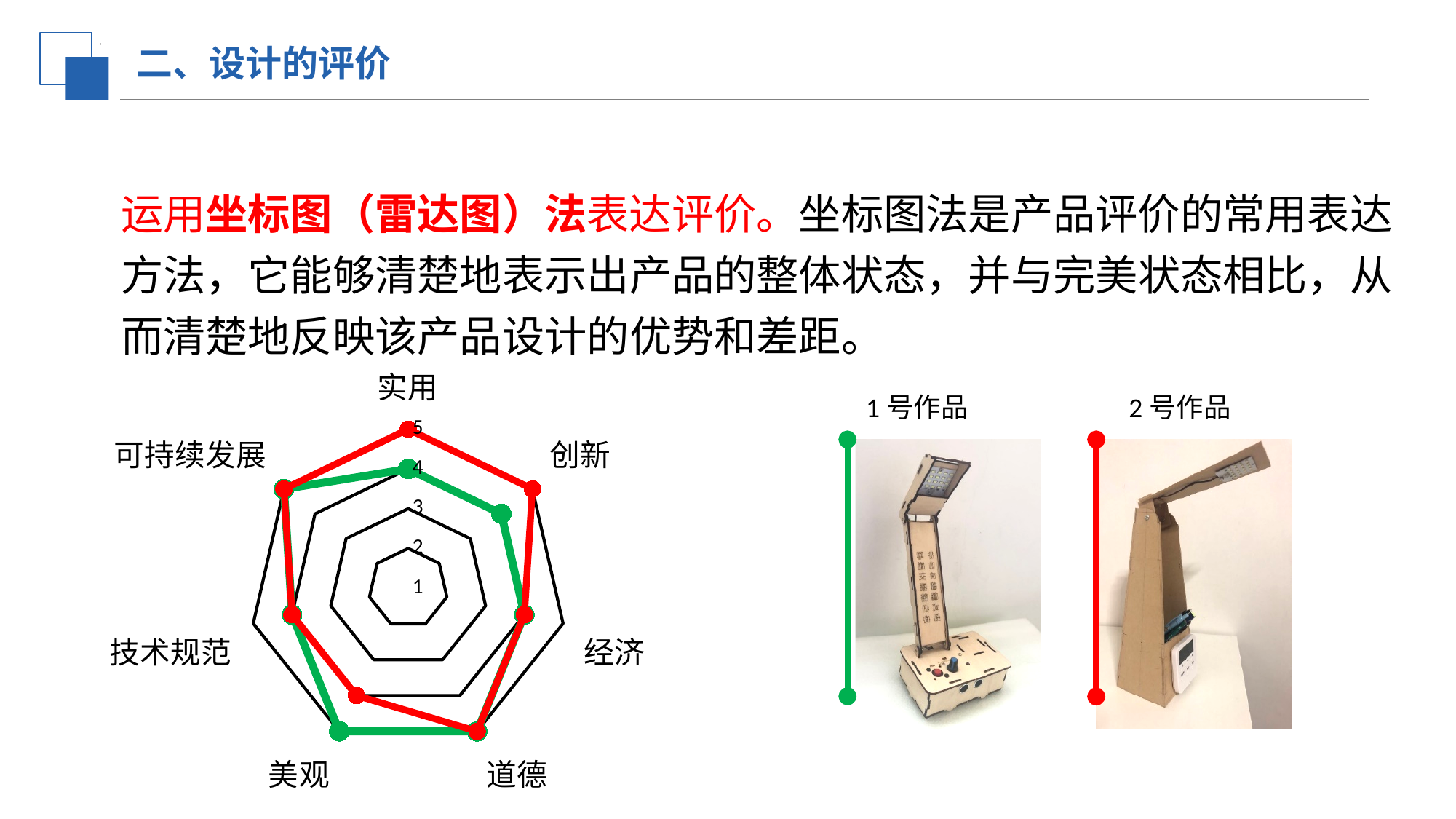
Which product scores higher on 实用, 1号作品 or 2号作品? 2号作品 What is the score of 1号作品 (green line) for 美观? 5 What is the highest value on the radar chart's scale? 5 What kind of chart is shown on the slide? radar chart Which product scores higher on 美观, 1号作品 or 2号作品? 1号作品 What is the score of 2号作品 (red line) for 美观? 4 What is the score of 1号作品 (green line) for 实用? 4 What is the difference between the 美观 scores of 1号作品 and 2号作品? 1 How many evaluation criteria (axes) does the radar chart have? 7 What is the score of 2号作品 (red line) for 实用? 5 How many products (series) are plotted on the radar chart? 2 Which colour line represents 1号作品 on the radar chart? green